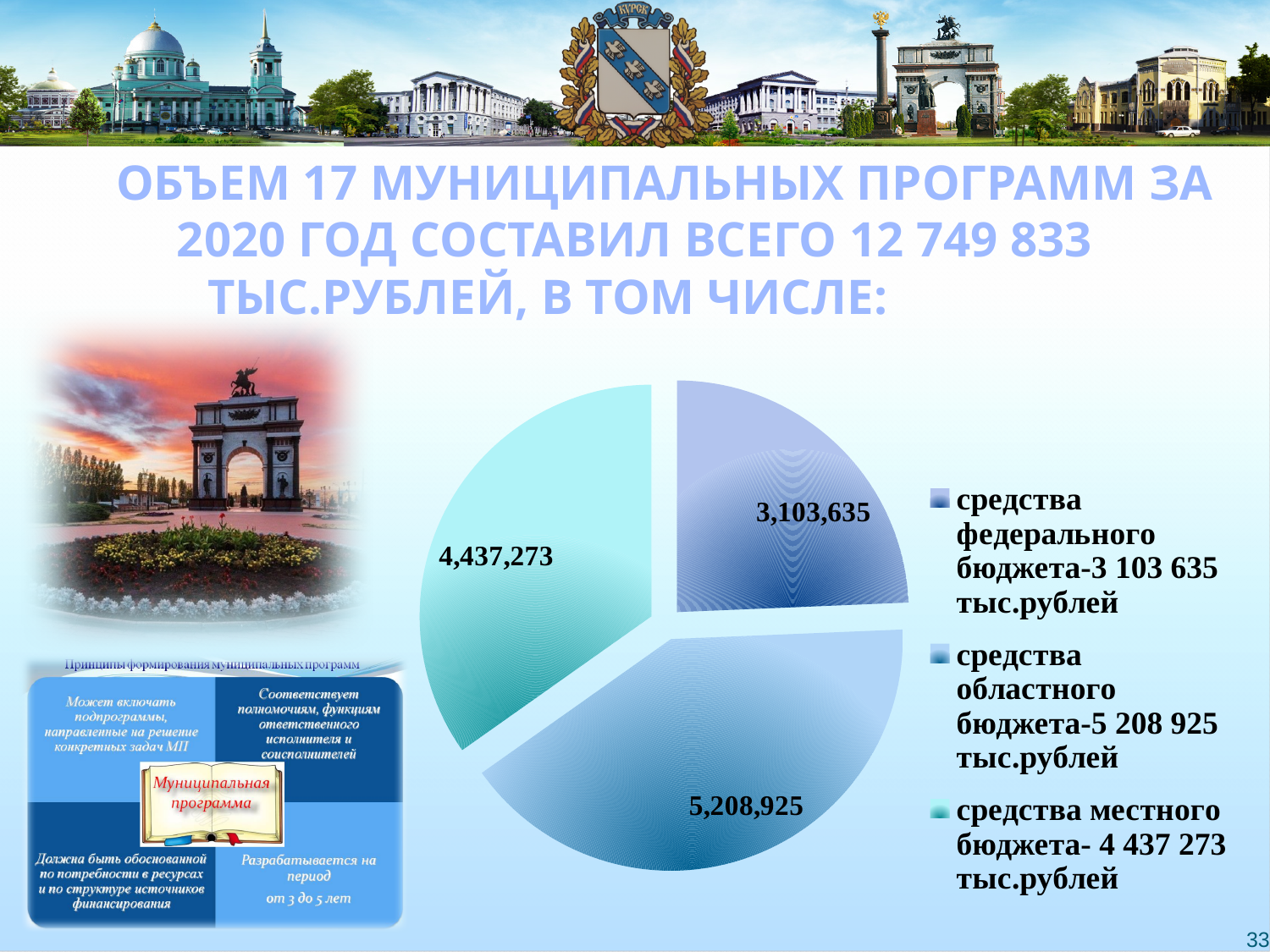
What value is shown for the federal budget funds (средства федерального бюджета) slice? 3,103,635 According to the slide title, what is the total volume of the 17 municipal programs for 2020? 12 749 833 тыс.рублей Which slice of the pie chart has the largest value? средства областного бюджета What value is shown for the local budget funds (средства местного бюджета) slice? 4,437,273 What is the difference between the local budget slice and the federal budget slice? 1,333,638 How many slices does the pie chart have? 3 What is the difference between the regional budget slice and the federal budget slice? 2,105,290 What value is shown for the regional budget funds (средства областного бюджета) slice? 5,208,925 Which is larger: the local budget slice or the regional budget slice? средства областного бюджета Which slice of the pie chart has the smallest value? средства федерального бюджета What kind of chart is shown on the slide? pie chart How many entries does the legend of the pie chart list? 3